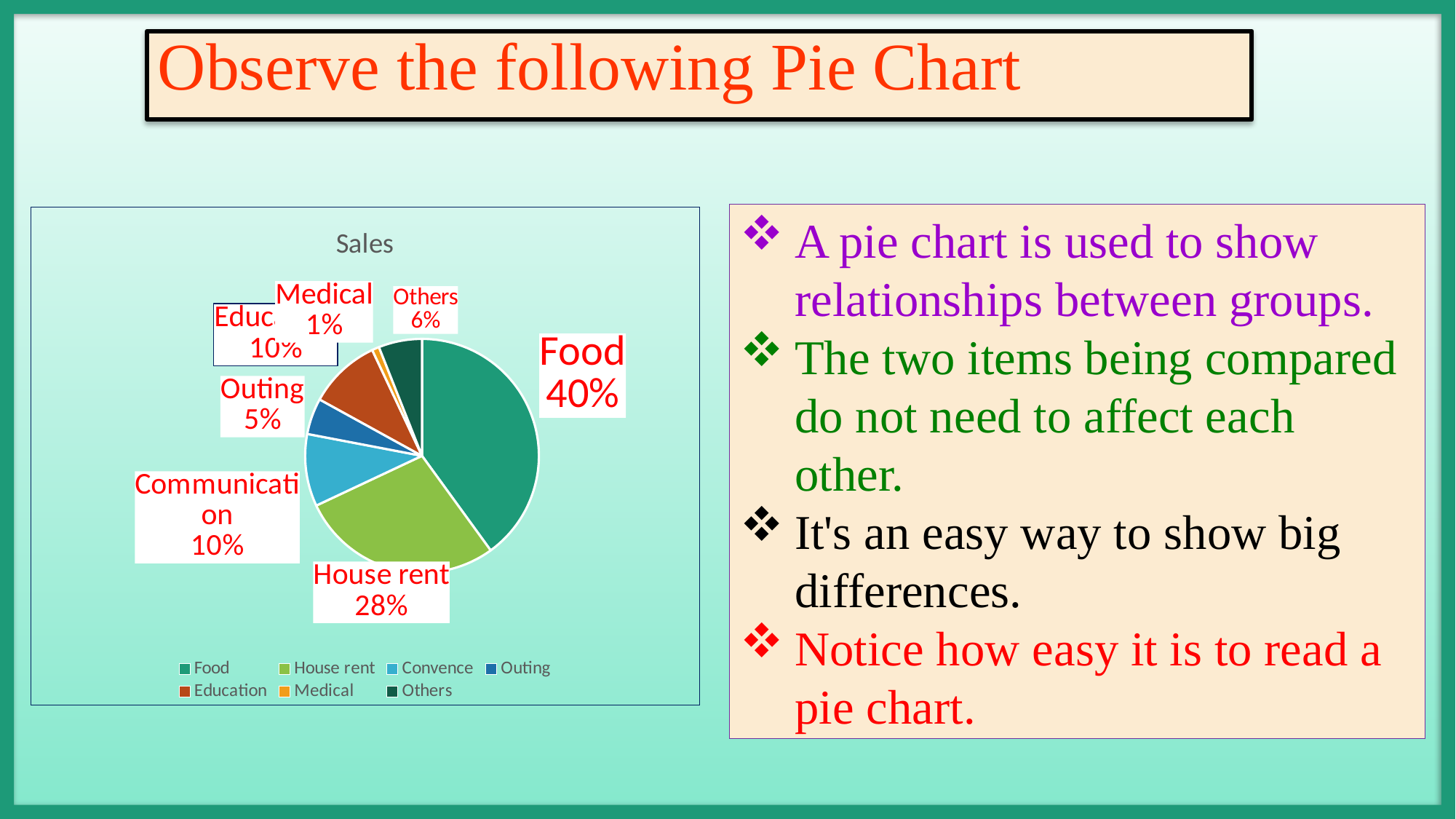
What percentage of the pie does Others account for? 6% What percentage of the pie does Outing account for? 5% Which category has the smallest slice of the pie? Medical What is the title of the chart? Sales What kind of chart is shown on the slide? pie chart What is the difference in percentage points between Food and House rent? 12 How many categories does the legend list? 7 What percentage of the pie does Medical account for? 1% What percentage of the pie does Food account for? 40% Which category has the largest slice of the pie? Food What percentage of the pie does House rent account for? 28% Which is larger, the Others slice or the Outing slice? Others